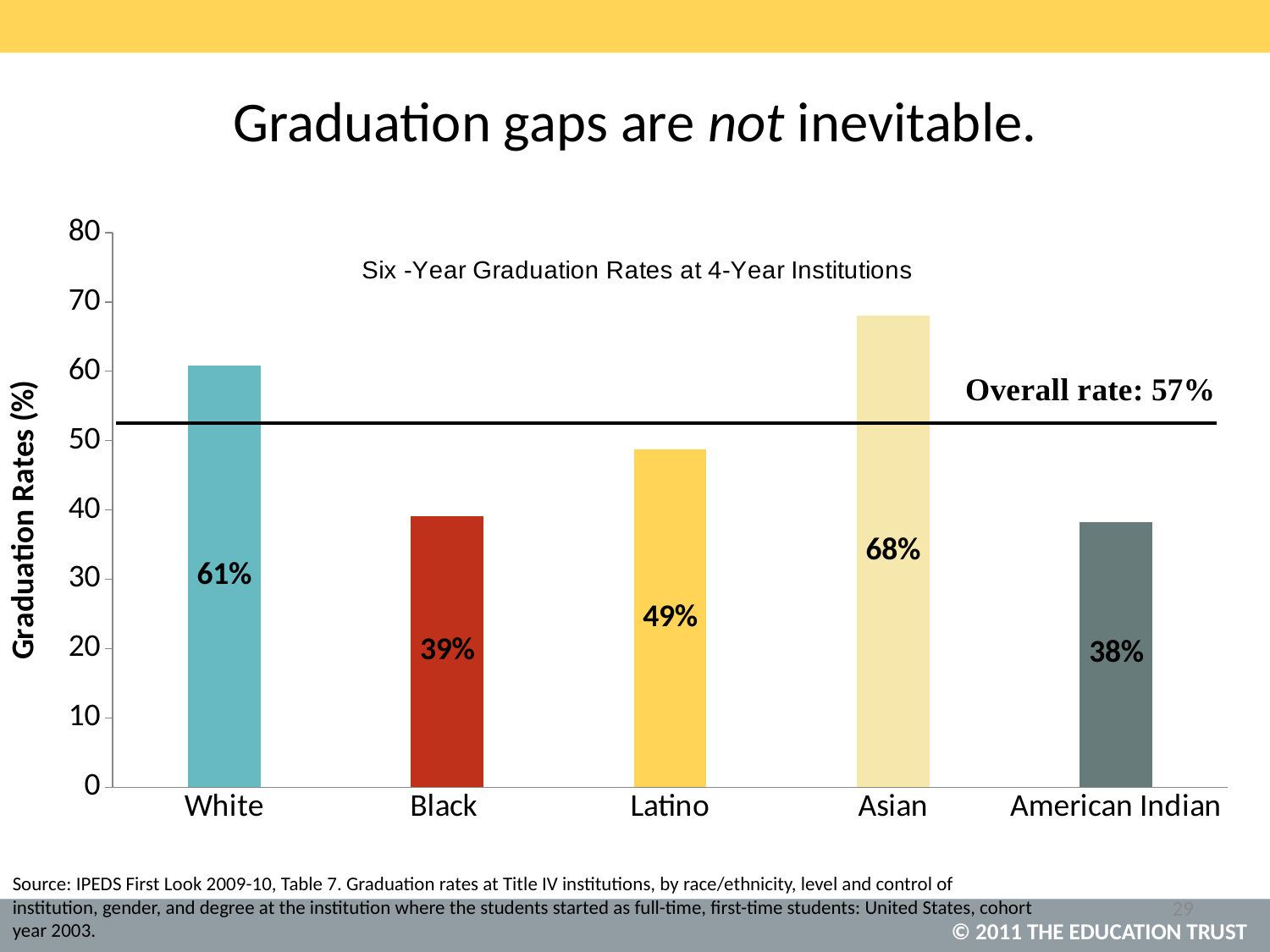
What is the six-year graduation rate for Black students? 39% What is the difference between the graduation rates for White and Latino students? 12% What is the six-year graduation rate for American Indian students? 38% What is the six-year graduation rate for White students? 61% Which group has a higher graduation rate, White or Latino? White Which group has the lowest six-year graduation rate? American Indian What type of chart is shown on the slide? Bar chart Which group has the highest six-year graduation rate? Asian What is the six-year graduation rate for Latino students? 49% How many racial/ethnic groups are shown on the chart? 5 What overall graduation rate is marked by the horizontal line on the chart? 57% What is the difference between the graduation rates for Asian and Black students? 29%